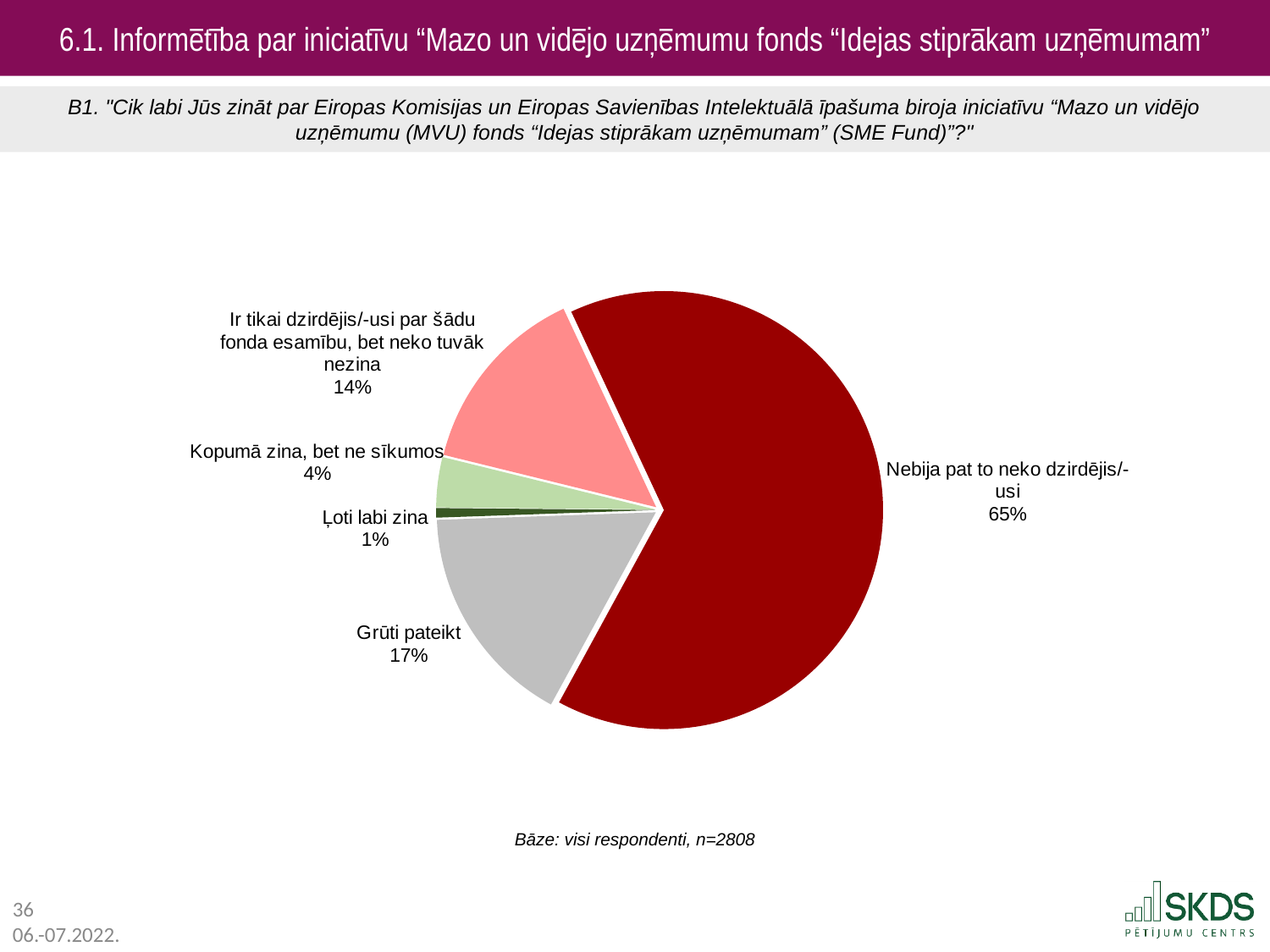
What kind of chart is shown on the slide? pie chart Which answer category has the largest slice of the pie? Nebija pat to neko dzirdējis/-usi What is the base (number of respondents) stated below the chart? n=2808 Which answer category has the smallest slice of the pie? Ļoti labi zina What share of respondents answered "Ir tikai dzirdējis/-usi par šādu fonda esamību, bet neko tuvāk nezina"? 14% What share of respondents answered "Grūti pateikt"? 17% What share of respondents answered "Nebija pat to neko dzirdējis/-usi"? 65% What share of respondents answered "Ļoti labi zina"? 1% What share of respondents answered "Kopumā zina, bet ne sīkumos"? 4% Which is larger: the share for "Kopumā zina, bet ne sīkumos" or the share for "Ļoti labi zina"? Kopumā zina, bet ne sīkumos What is the difference in percentage points between "Grūti pateikt" and "Ir tikai dzirdējis/-usi par šādu fonda esamību, bet neko tuvāk nezina"? 3 percentage points How many answer categories are shown in the pie chart? 5